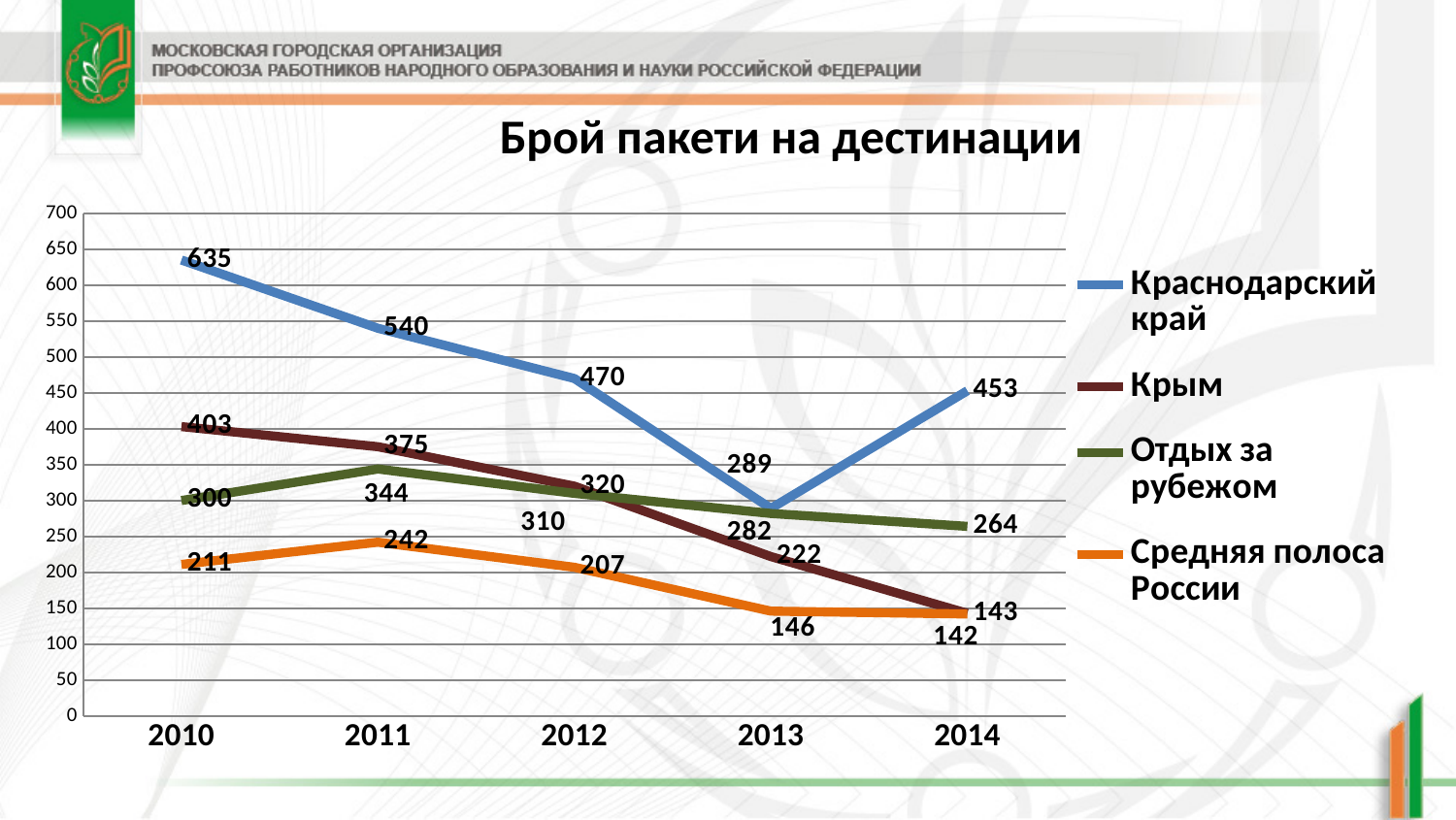
Does the value for Крым rise or fall from 2010 to 2014? fall Which is larger in 2013: the value for Краснодарский край or the value for Отдых за рубежом? Краснодарский край In which year is the value for Краснодарский край lowest? 2013 What is the difference between the Краснодарский край values in 2010 and 2011? 95 How many years are shown on the x axis? 5 How many series does the legend list? 4 Which series has the highest value in 2010? Краснодарский край What type of chart is shown on the slide? line chart What is the value for Крым in 2013? 222 What is the value for Отдых за рубежом in 2011? 344 What is the value for Средняя полоса России in 2013? 146 What is the value for Краснодарский край in 2010? 635